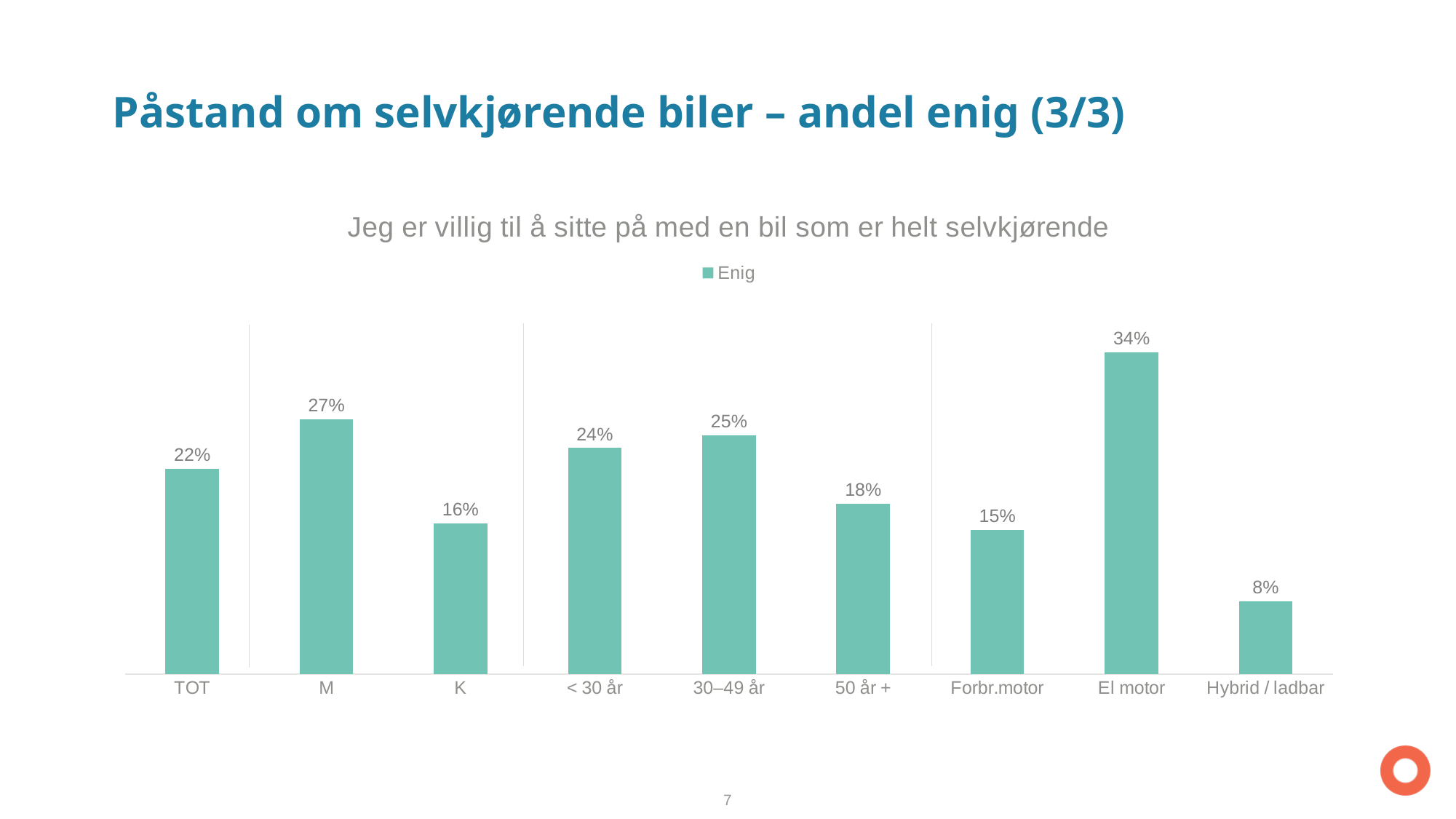
What is the title of the chart? Jeg er villig til å sitte på med en bil som er helt selvkjørende What is the difference between the values for M and K? 11% How many series does the legend list? 1 How many categories are shown on the x axis? 9 What is the value for El motor? 34% Which category has the highest value? El motor What is the value for 50 år +? 18% Which category has the lowest value? Hybrid / ladbar What is the value for TOT? 22% What is the name of the series in the legend? Enig Which is larger, the value for < 30 år or the value for 50 år +? < 30 år What kind of chart is shown? bar chart